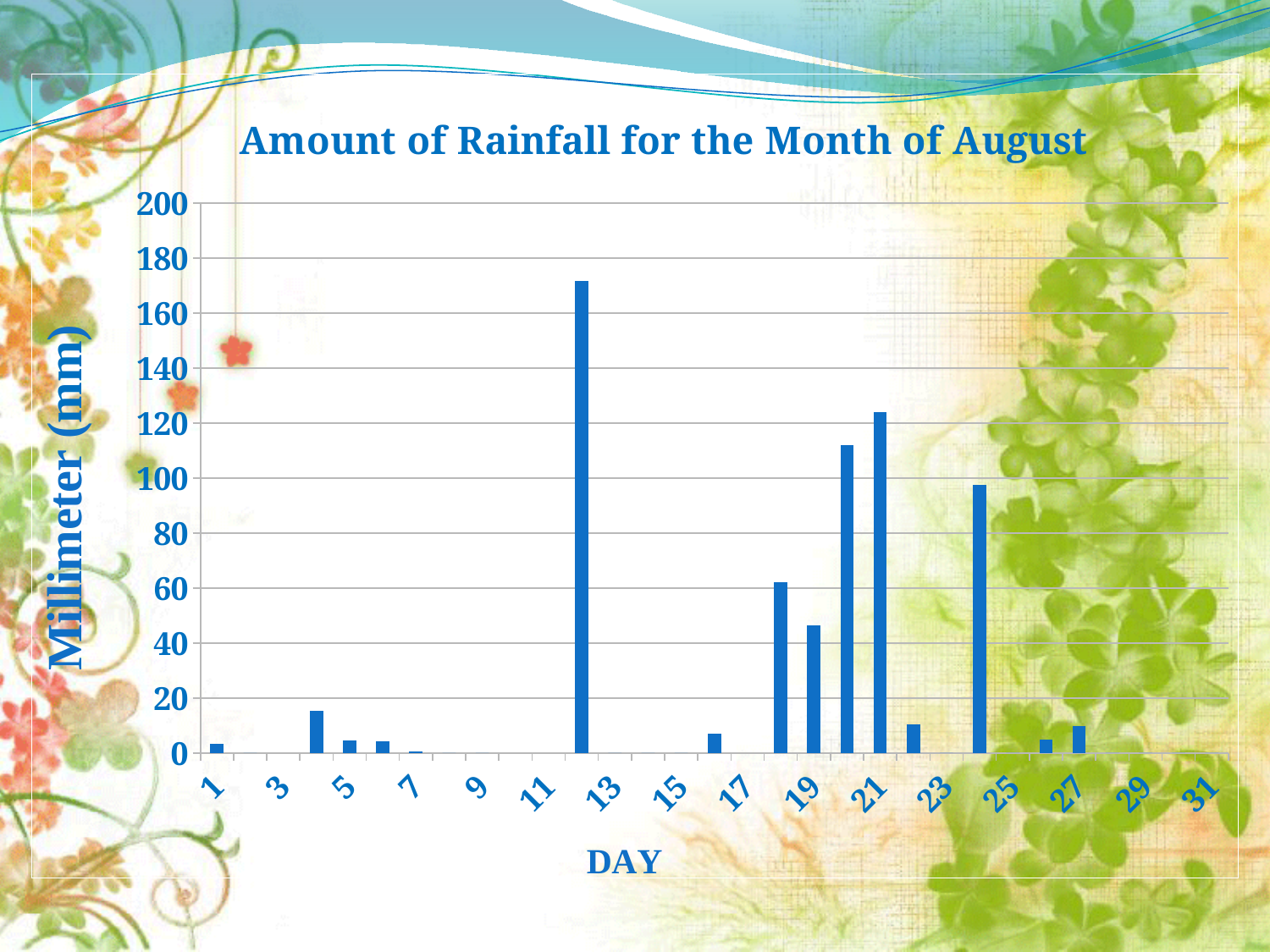
Is the value of the tallest bar (day 12) greater or less than 160? greater What is the label of the vertical axis? Millimeter (mm) What type of chart is shown on the slide? bar chart How many day labels are printed along the x axis? 16 Is the value for day 4 greater or less than 20? less Is the value for day 19 greater or less than 60? less Which is larger, the rainfall on day 18 or on day 19? day 18 Which is larger, the rainfall on day 20 or on day 21? day 21 What is the title of the chart? Amount of Rainfall for the Month of August Which day has the tallest bar (highest rainfall) in the chart? 12